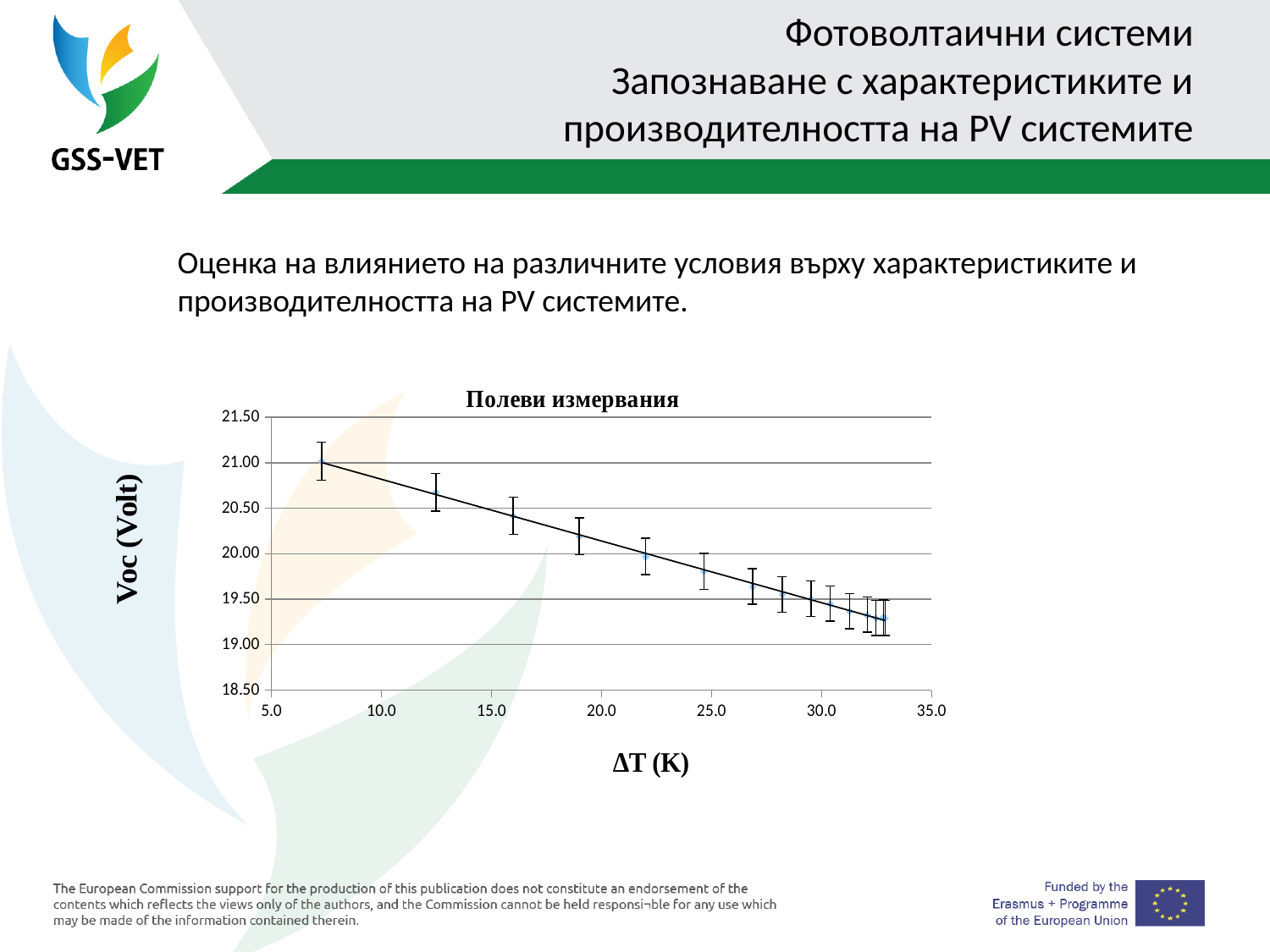
Which has the larger Voc value: the leftmost point or the rightmost point? the leftmost point Is the Voc value of the point at about ΔT = 12.5 K greater or less than 20.00? greater What is the title of the chart? Полеви измервания What kind of chart is shown on the slide? scatter chart Is the Voc value of the leftmost point (at about ΔT = 7.5 K) greater or less than 20.50? greater Is the Voc value of the rightmost point (at about ΔT = 33 K) greater or less than 19.50? less What is the highest value shown on the y axis? 21.50 What is the label of the y axis? Voc (Volt) Do the Voc values rise or fall as ΔT increases along the x axis? fall